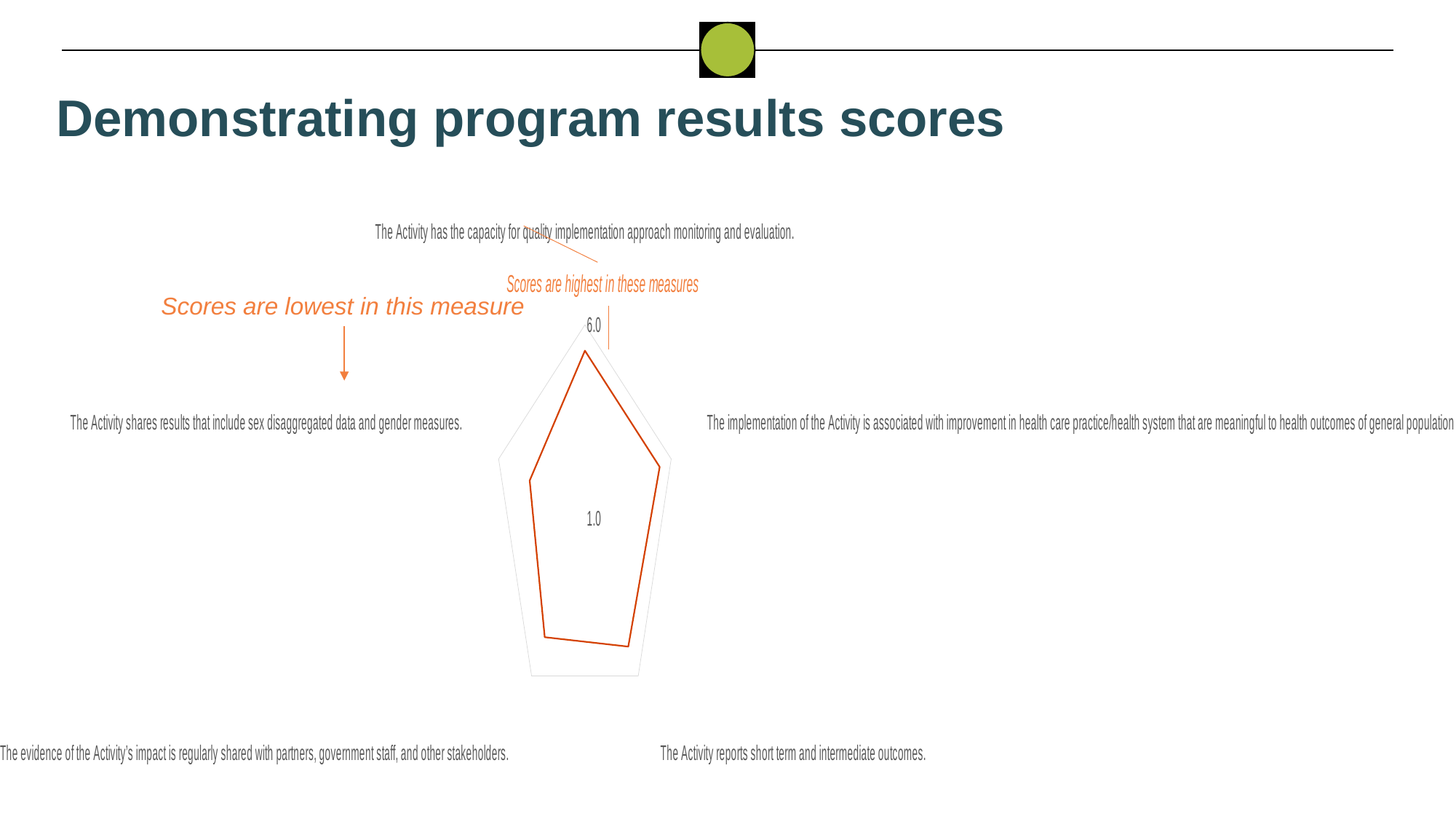
Which measure has the lowest score on the radar chart? The Activity shares results that include sex disaggregated data and gender measures. Is the score for 'The Activity shares results that include sex disaggregated data and gender measures' greater or less than 6.0? less Is the score for 'The Activity has the capacity for quality implementation approach monitoring and evaluation' greater or less than 1.0? greater Which has the larger score: 'The Activity has the capacity for quality implementation approach monitoring and evaluation' or 'The Activity shares results that include sex disaggregated data and gender measures'? The Activity has the capacity for quality implementation approach monitoring and evaluation. What is the highest axis value labelled on the radar chart? 6.0 What kind of chart is shown on the slide? Radar chart How many measures (axes) does the radar chart plot? 5 Which has the larger score: 'The Activity reports short term and intermediate outcomes' or 'The Activity shares results that include sex disaggregated data and gender measures'? The Activity reports short term and intermediate outcomes. What is the title of the slide containing the radar chart? Demonstrating program results scores